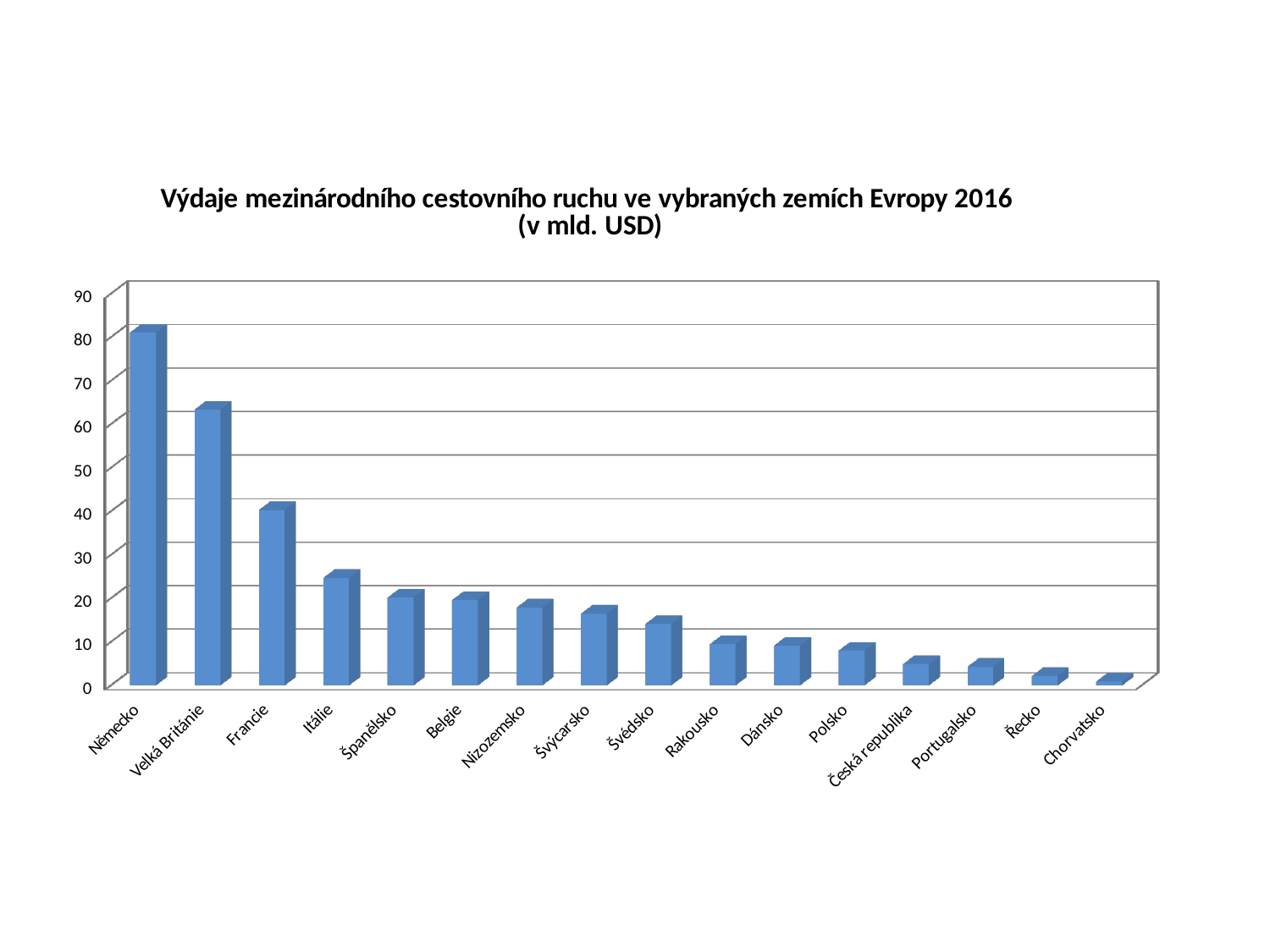
Do the values rise or fall moving from left to right along the x axis? fall Which has a larger value, Francie or Itálie? Francie What unit is given in the chart title for the values? mld. USD Is the value for Velká Británie greater or less than 50? greater Is the value for Španělsko greater or less than 30? less Which country has the lowest value in the chart? Chorvatsko Is the value for Německo greater or less than 70? greater Which country has the highest value in the chart? Německo How many countries are shown on the x axis of the chart? 16 What kind of chart is shown on the slide? bar chart